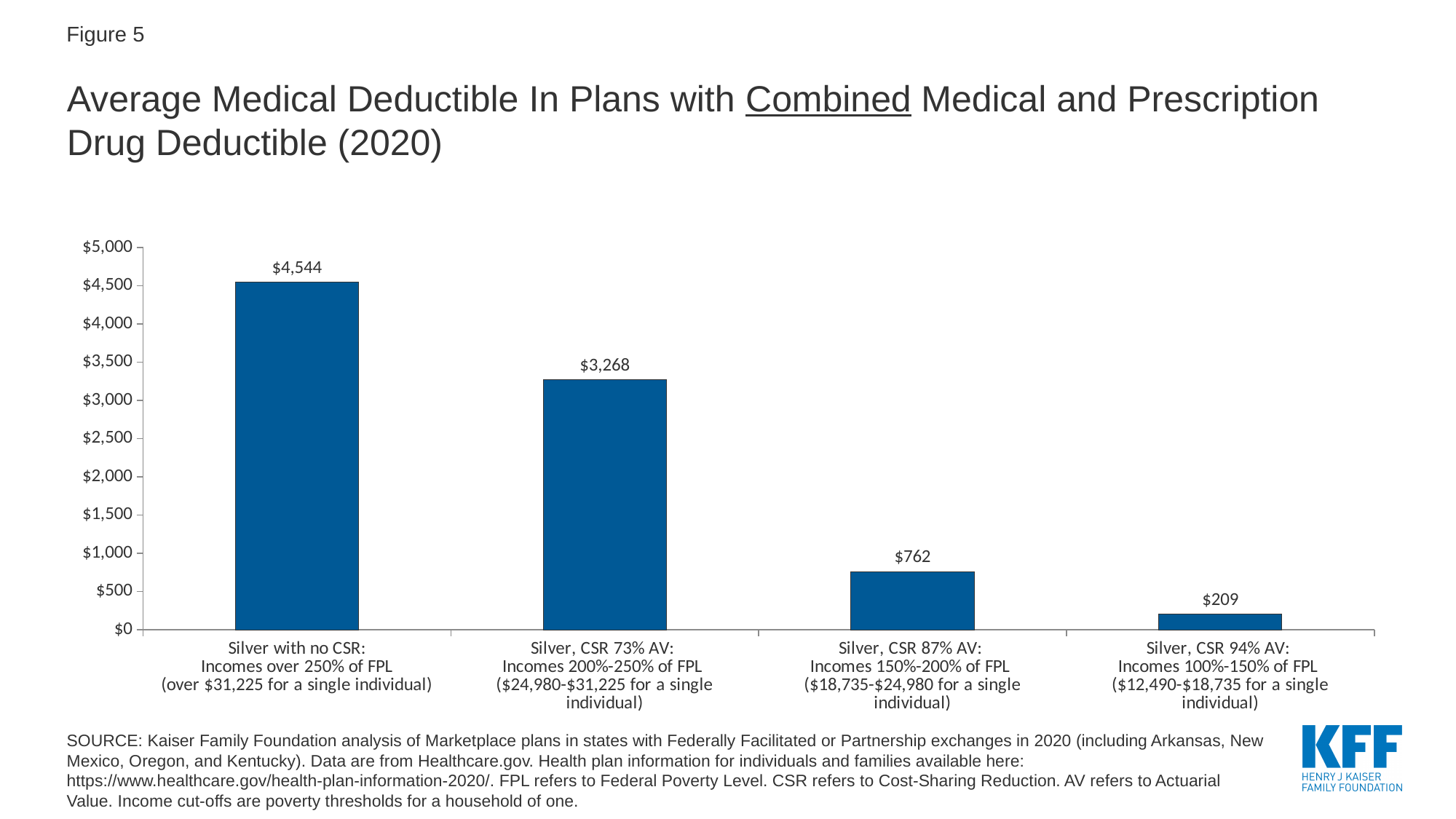
Do the deductible values rise or fall moving from left to right across the categories? Fall What is the average medical deductible for Silver, CSR 94% AV plans? $209 What is the average medical deductible for Silver, CSR 87% AV plans? $762 How many plan categories are shown in the chart? 4 Which plan category has the highest average medical deductible? Silver with no CSR Which has a larger average deductible: Silver, CSR 73% AV or Silver, CSR 87% AV? Silver, CSR 73% AV What is the difference between the average deductible for Silver, CSR 87% AV and Silver, CSR 94% AV? $553 Which plan category has the lowest average medical deductible? Silver, CSR 94% AV What type of chart is shown on the slide? Bar chart What is the average medical deductible for Silver, CSR 73% AV plans? $3,268 What is the average medical deductible for Silver plans with no CSR? $4,544 What is the difference between the average deductible for Silver with no CSR and Silver, CSR 73% AV? $1,276